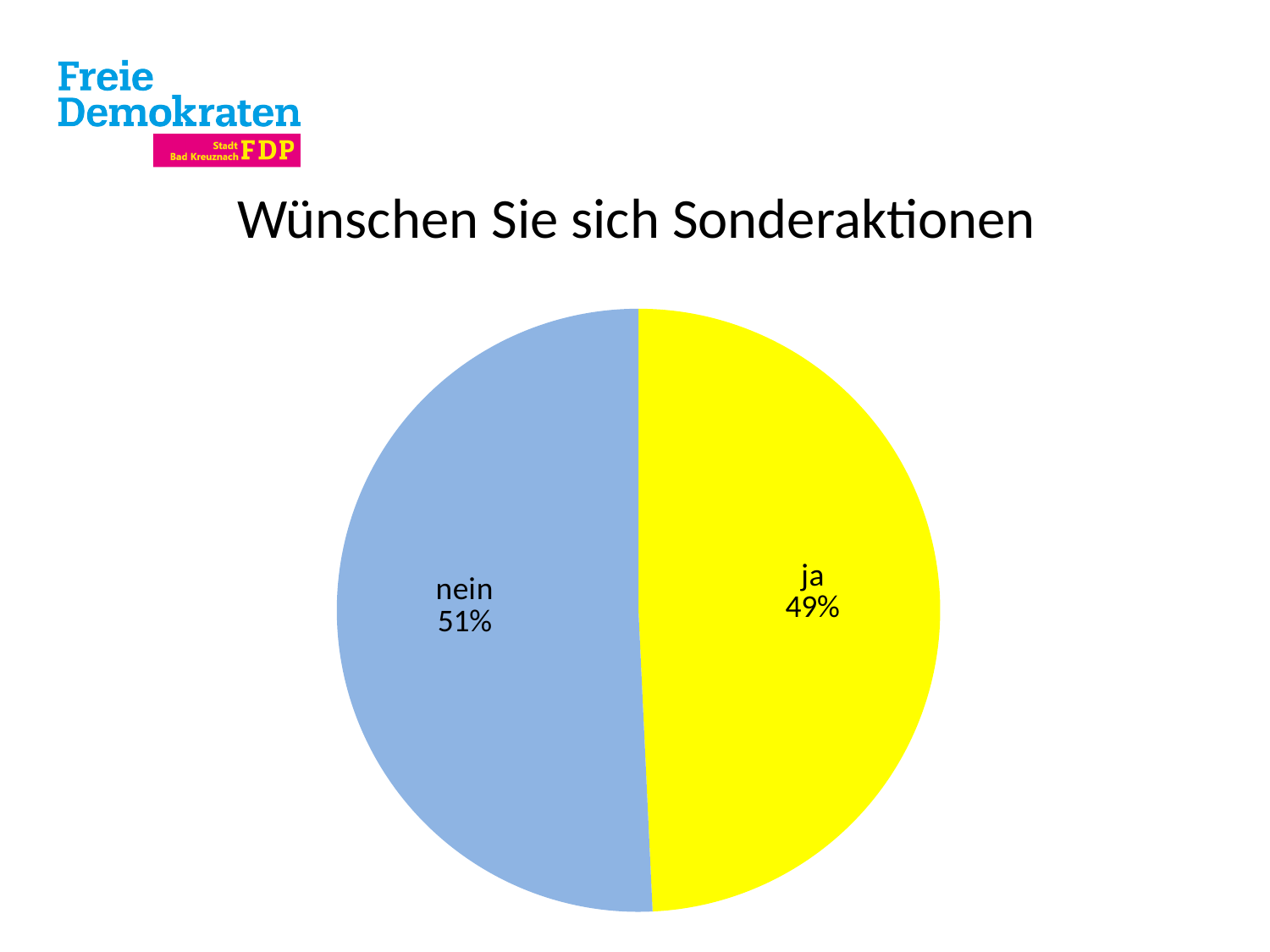
What share of the pie does the "nein" slice represent? 51% What is the difference in percentage points between the "nein" and "ja" shares? 2 percentage points What kind of chart is shown on the slide? Pie chart Which category has the smallest share of the pie? ja What is the title of the chart? Wünschen Sie sich Sonderaktionen How many categories are shown in the pie chart? 2 What share of the pie does the "ja" slice represent? 49% What is the value shown for the "ja" category? 49% Which category has the larger share, "ja" or "nein"? nein What colour is the "ja" slice of the pie? Yellow What is the value shown for the "nein" category? 51% Which category has the largest share of the pie? nein